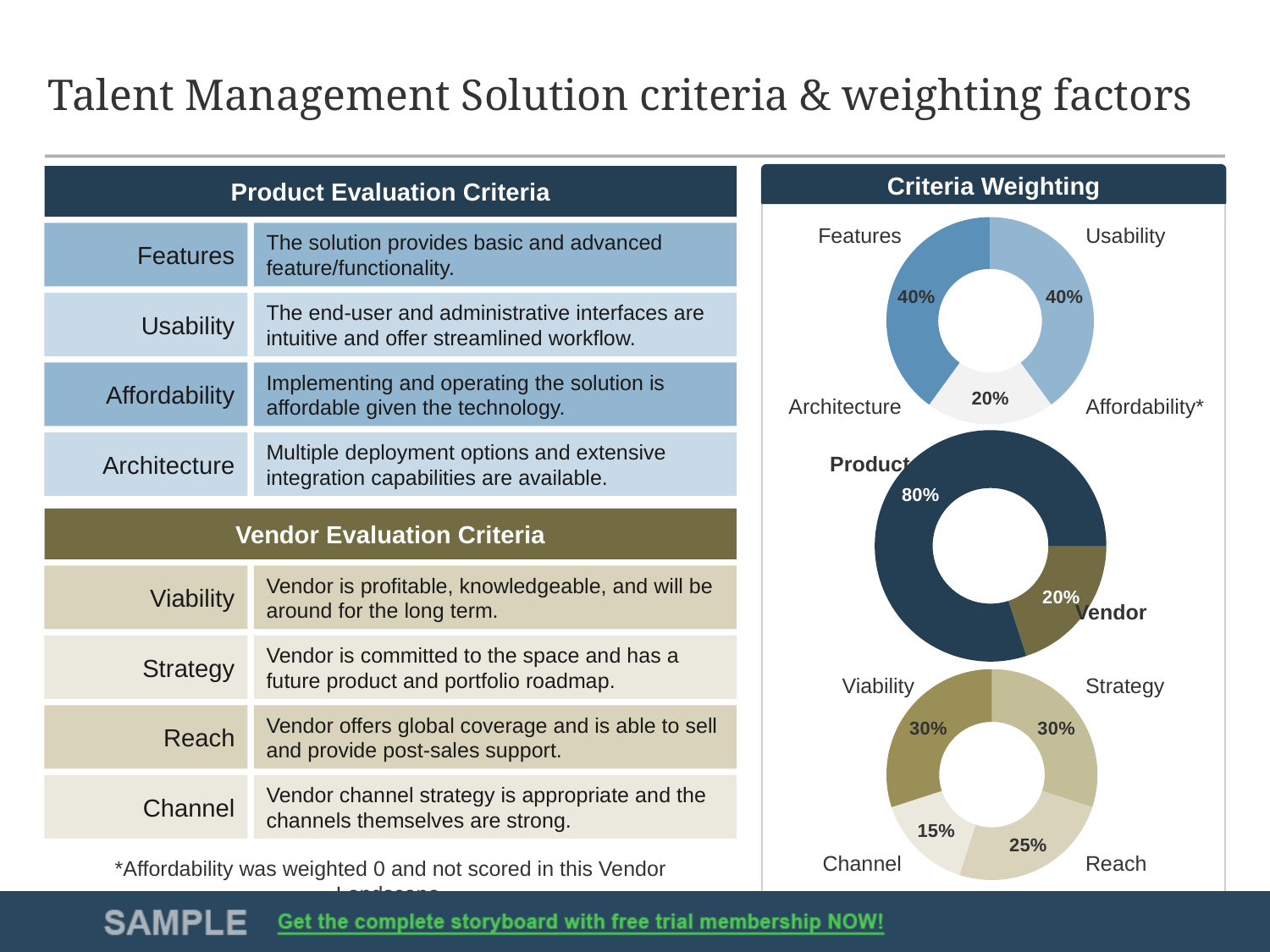
In the top donut chart, what is the weighting for Architecture? 20% What type of chart is used to show the criteria weighting? Donut chart In the top donut chart, what is the weighting for Features? 40% In the bottom donut chart, which is larger, the weighting for Strategy or for Reach? Strategy In the middle donut chart, what is the difference between the Product and Vendor weightings? 60% In the bottom donut chart, what is the difference between the weightings for Viability and Channel? 15% How many criteria are labelled on the bottom donut chart? 4 In the middle donut chart, what is the weighting for Product? 80% What is the title above the three donut charts? Criteria Weighting In the middle donut chart, what is the weighting for Vendor? 20% In the bottom donut chart, which criterion has the lowest weighting? Channel In the bottom donut chart, what is the weighting for Reach? 25%